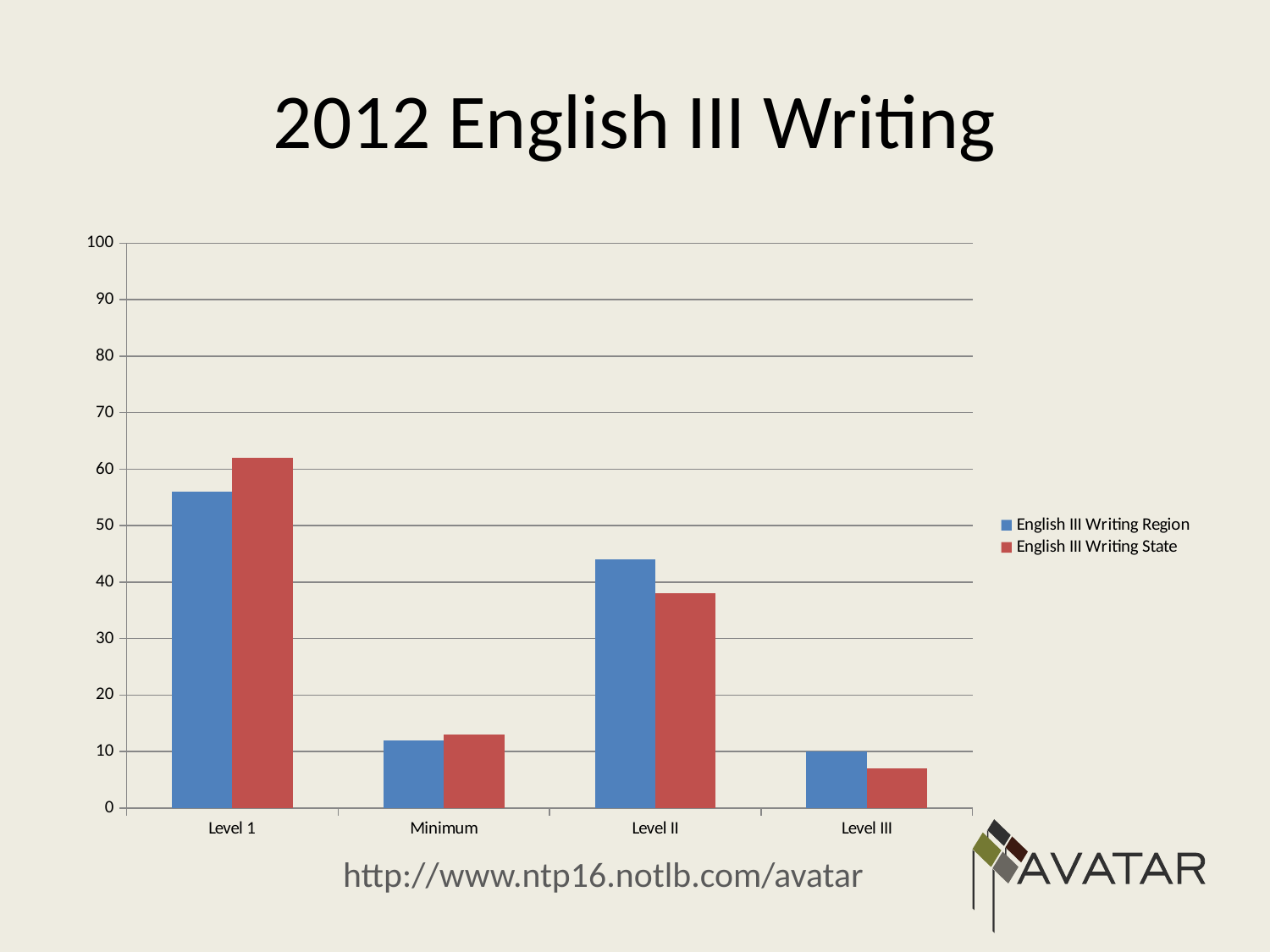
How many series does the legend list? 2 For Level 1, which is larger: English III Writing Region or English III Writing State? English III Writing State Which category has the highest value for English III Writing State? Level 1 Is the value for English III Writing State at Minimum greater or less than 20? less For Level III, which is larger: English III Writing Region or English III Writing State? English III Writing Region How many categories are shown on the x axis? 4 Which category has the lowest value for English III Writing Region? Level III For Level II, which is larger: English III Writing Region or English III Writing State? English III Writing Region What is the title of the chart on the slide? 2012 English III Writing Is the value for English III Writing State at Level II greater or less than 40? less Is the value for English III Writing Region at Level 1 greater or less than 50? greater What kind of chart is shown on the slide? bar chart